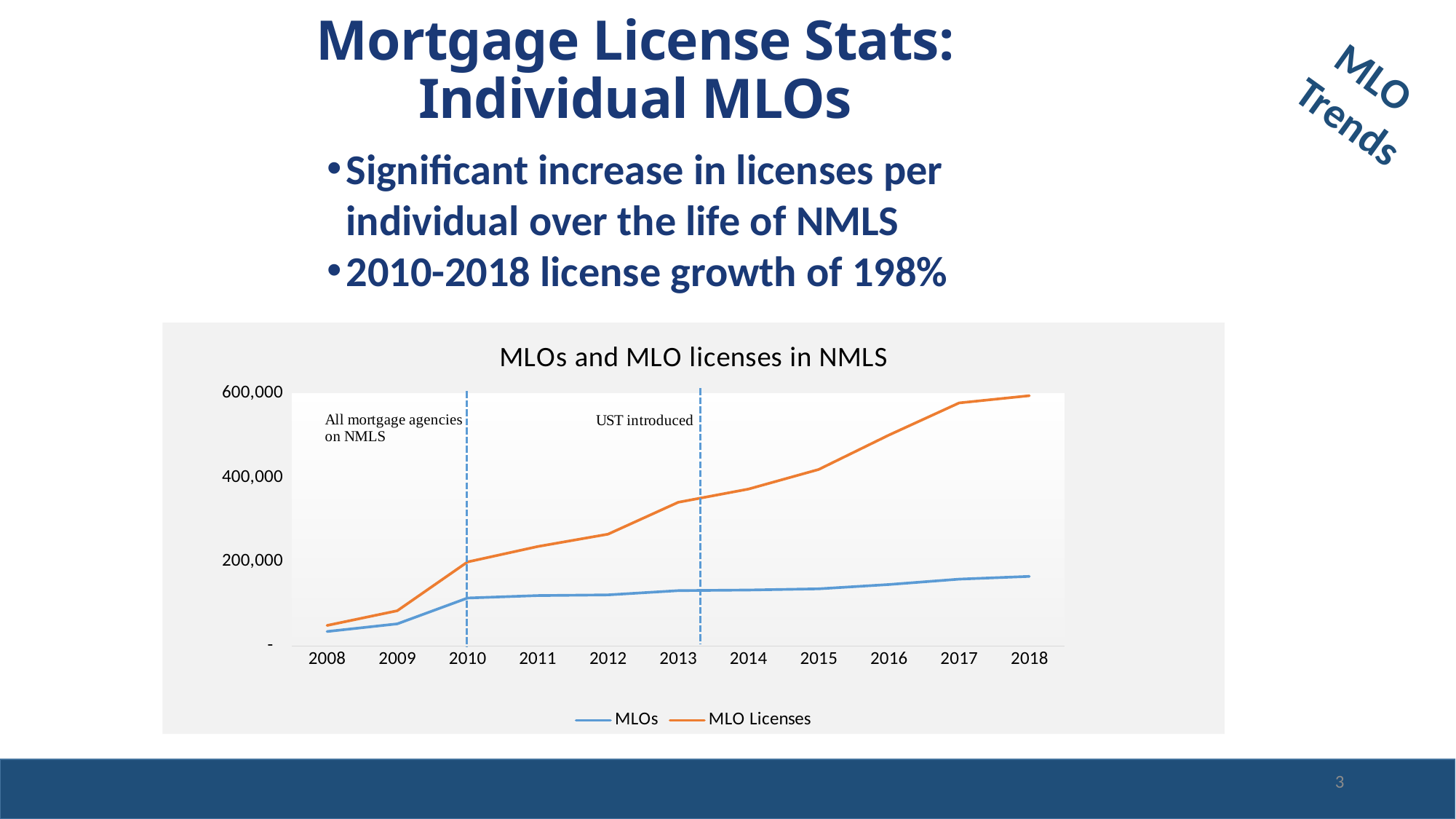
What is the title of the chart? MLOs and MLO licenses in NMLS How many series does the chart legend list? 2 How many years are plotted along the x axis of the chart? 11 In which year is the MLOs value lowest? 2008 In 2018, which series has the larger value, MLOs or MLO Licenses? MLO Licenses What kind of chart is shown on the slide? line chart Do the MLO Licenses values rise or fall from 2008 to 2018? rise Is the value for MLO Licenses in 2013 greater or less than 400,000? less In which year is the MLO Licenses value highest? 2018 Which series is drawn in orange in the chart? MLO Licenses Is the value for MLOs in 2018 greater or less than 200,000? less Is the value for MLO Licenses in 2018 greater or less than 400,000? greater